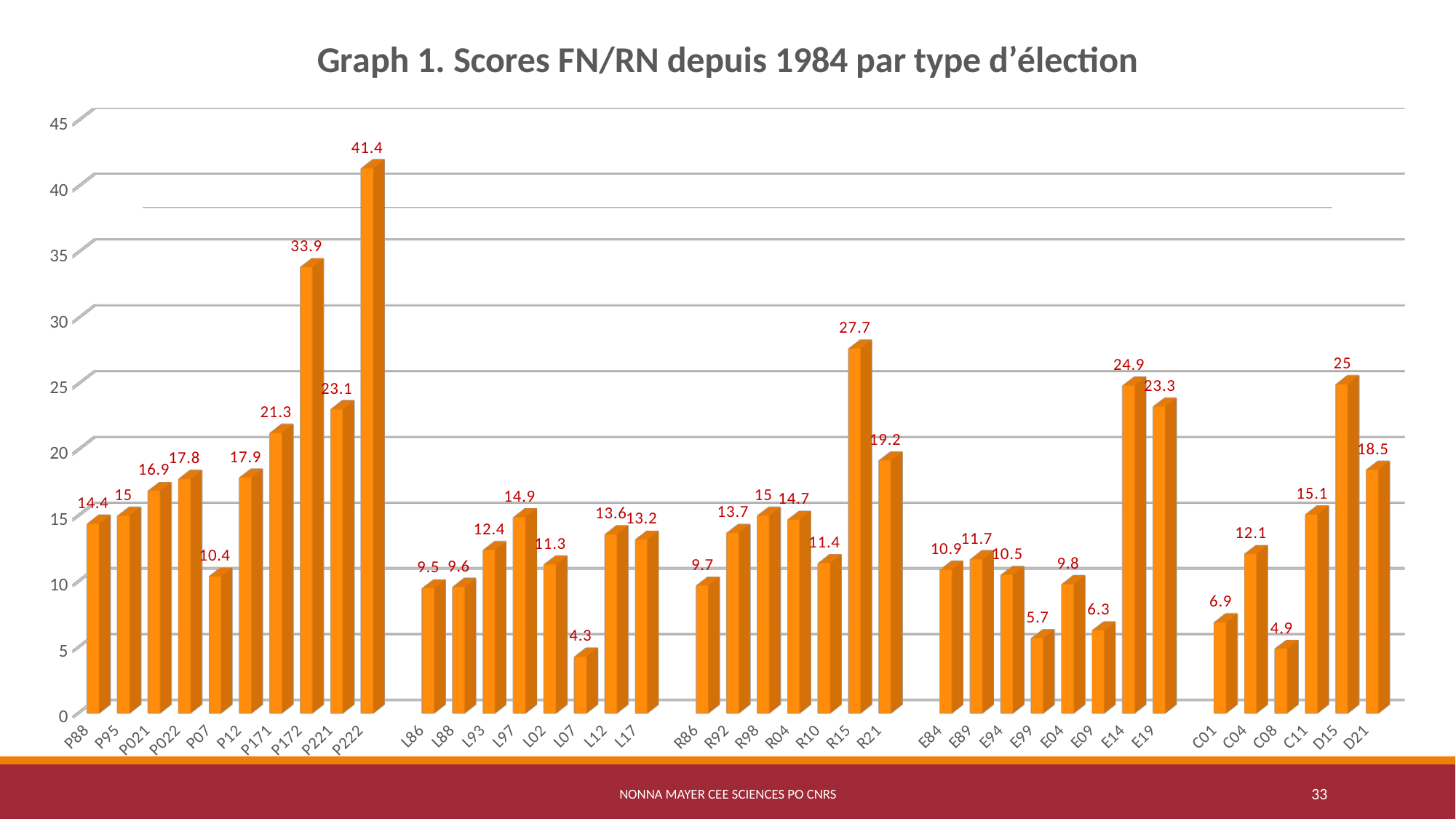
Which is larger, the value for D15 or the value for E19? D15 Do the values rise or fall from E99 to E14? Rise What is the value for P222? 41.4 Is the value for P172 greater or less than 30? greater What is the difference between the values for P222 and P172? 7.5 What kind of chart is this? Bar chart Which category has the lowest value? L07 How many categories are shown on the x axis? 39 What is the title of the chart? Graph 1. Scores FN/RN depuis 1984 par type d’élection What is the value for E14? 24.9 Which category has the highest value? P222 What is the value for R15? 27.7